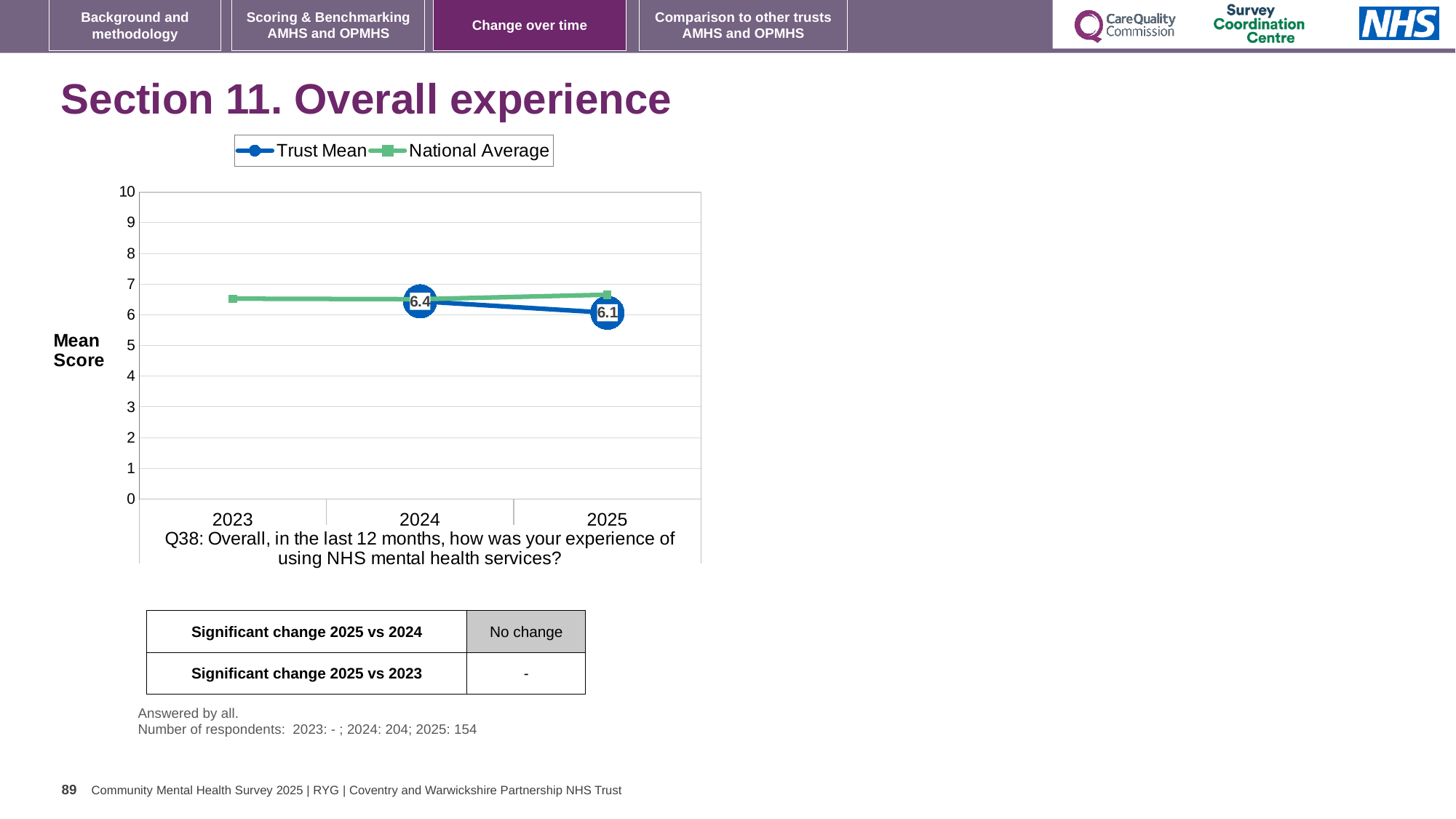
Is the National Average value for 2023 greater or less than 7? less What kind of chart is shown on the slide? line chart How many series does the legend list? 2 What is the label on the y axis of the chart? Mean Score Does the Trust Mean rise or fall from 2024 to 2025? fall Which year has the higher Trust Mean, 2024 or 2025? 2024 Is the National Average value for 2025 greater or less than 5? greater What is the Trust Mean value for 2024? 6.4 What is the Trust Mean value for 2025? 6.1 By how much did the Trust Mean change between 2024 and 2025? 0.3 How many years are shown on the x axis? 3 In 2025, which series is higher, Trust Mean or National Average? National Average